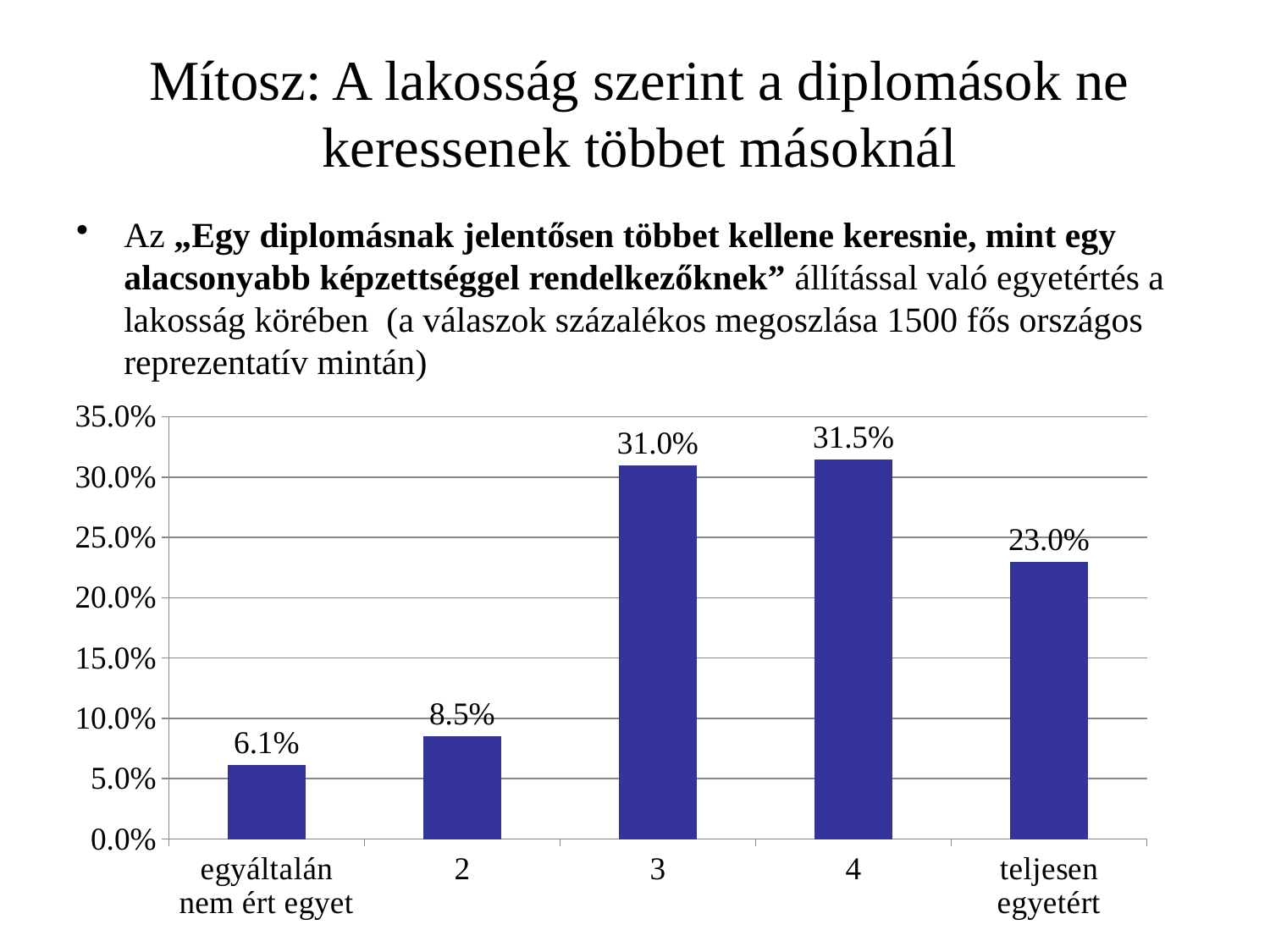
Which category has the highest value? 4 What kind of chart is shown on the slide? bar chart What is the value for the category "egyáltalán nem ért egyet"? 6.1% What is the difference between the values for "teljesen egyetért" and "egyáltalán nem ért egyet"? 16.9% Which is larger, the value for category 2 or the value for "teljesen egyetért"? teljesen egyetért What is the highest value shown on the y axis? 35.0% What is the value for category 3? 31.0% What is the difference between the values for category 4 and category 3? 0.5% Is the value for category 2 greater or less than 10.0%? less What is the value for the category "teljesen egyetért"? 23.0% How many categories are shown on the x axis? 5 Which category has the lowest value? egyáltalán nem ért egyet